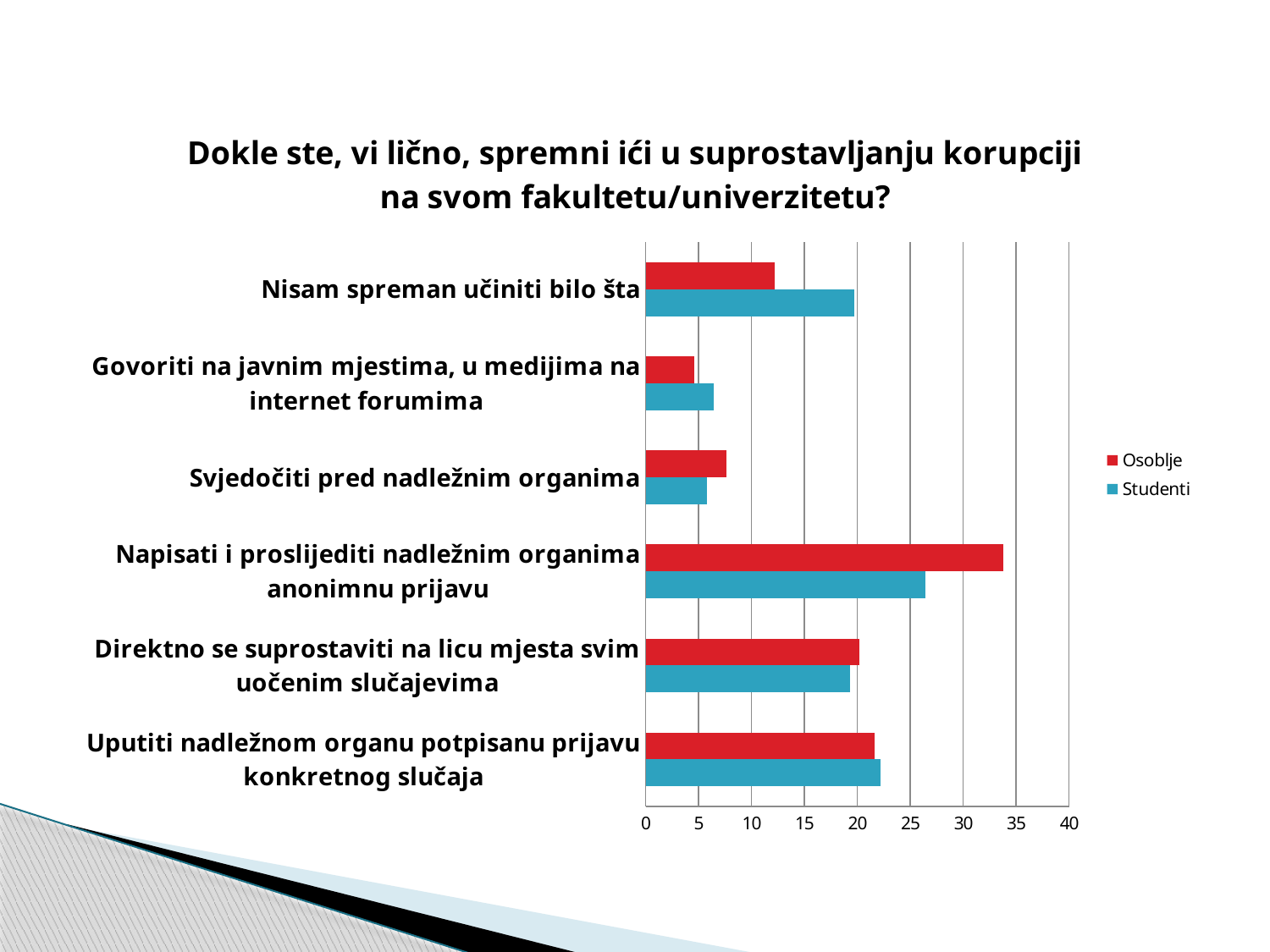
Is the Studenti value for "Govoriti na javnim mjestima, u medijima na internet forumima" greater or less than 10? less What kind of chart is shown on the slide? bar chart How many categories are shown on the chart? 6 Is the Osoblje value for "Napisati i proslijediti nadležnim organima anonimnu prijavu" greater or less than 30? greater Which category has the lowest value for Osoblje? Govoriti na javnim mjestima, u medijima na internet forumima For "Napisati i proslijediti nadležnim organima anonimnu prijavu", which series has the larger value, Osoblje or Studenti? Osoblje Which category has the highest value for Studenti? Napisati i proslijediti nadležnim organima anonimnu prijavu For "Nisam spreman učiniti bilo šta", which series has the larger value, Osoblje or Studenti? Studenti Is the Osoblje value for "Nisam spreman učiniti bilo šta" greater or less than 10? greater Which category has the highest value for Osoblje? Napisati i proslijediti nadležnim organima anonimnu prijavu How many series does the legend list? 2 Which colour represents the Osoblje series in the chart? red